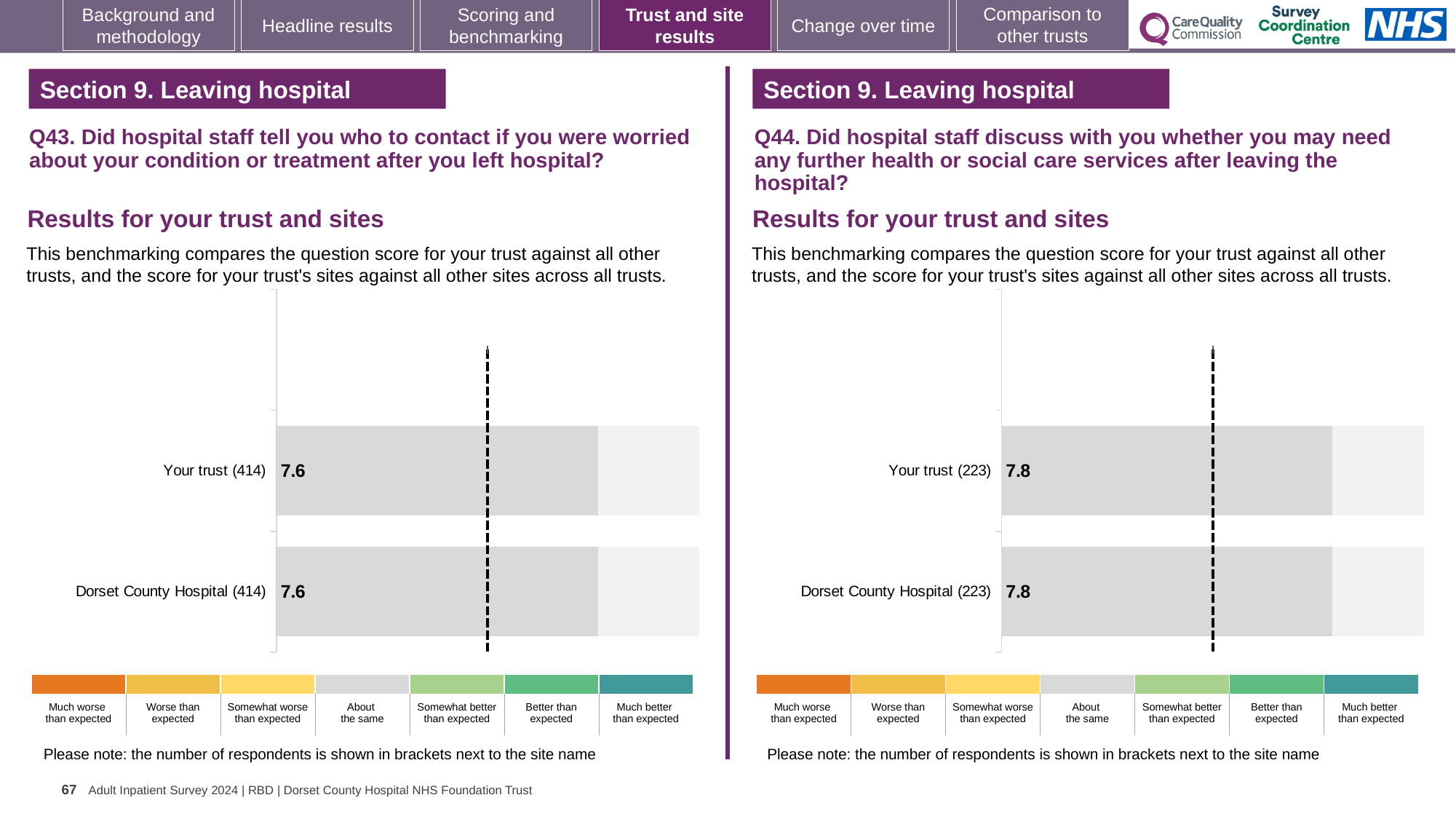
In the Q43 chart on the left, what is the difference between the score for Your trust and the score for Dorset County Hospital? 0 How many bars are plotted in the Q44 chart on the right? 2 In the Q43 chart on the left, how many respondents are shown in brackets next to Your trust? 414 In the Q43 chart on the left, what is the score for Dorset County Hospital? 7.6 In the Q44 chart on the right, what is the score for Your trust? 7.8 Is the score for Your trust in the Q44 chart on the right larger or smaller than the score for Your trust in the Q43 chart on the left? Larger What kind of chart is used for the Q43 results on the left? Bar chart In the Q43 chart on the left, what is the score for Your trust? 7.6 How many bars are plotted in the Q43 chart on the left? 2 In the Q44 chart on the right, what is the score for Dorset County Hospital? 7.8 In the Q44 chart on the right, what is the difference between the score for Your trust and the score for Dorset County Hospital? 0 In the Q44 chart on the right, how many respondents are shown in brackets next to Dorset County Hospital? 223